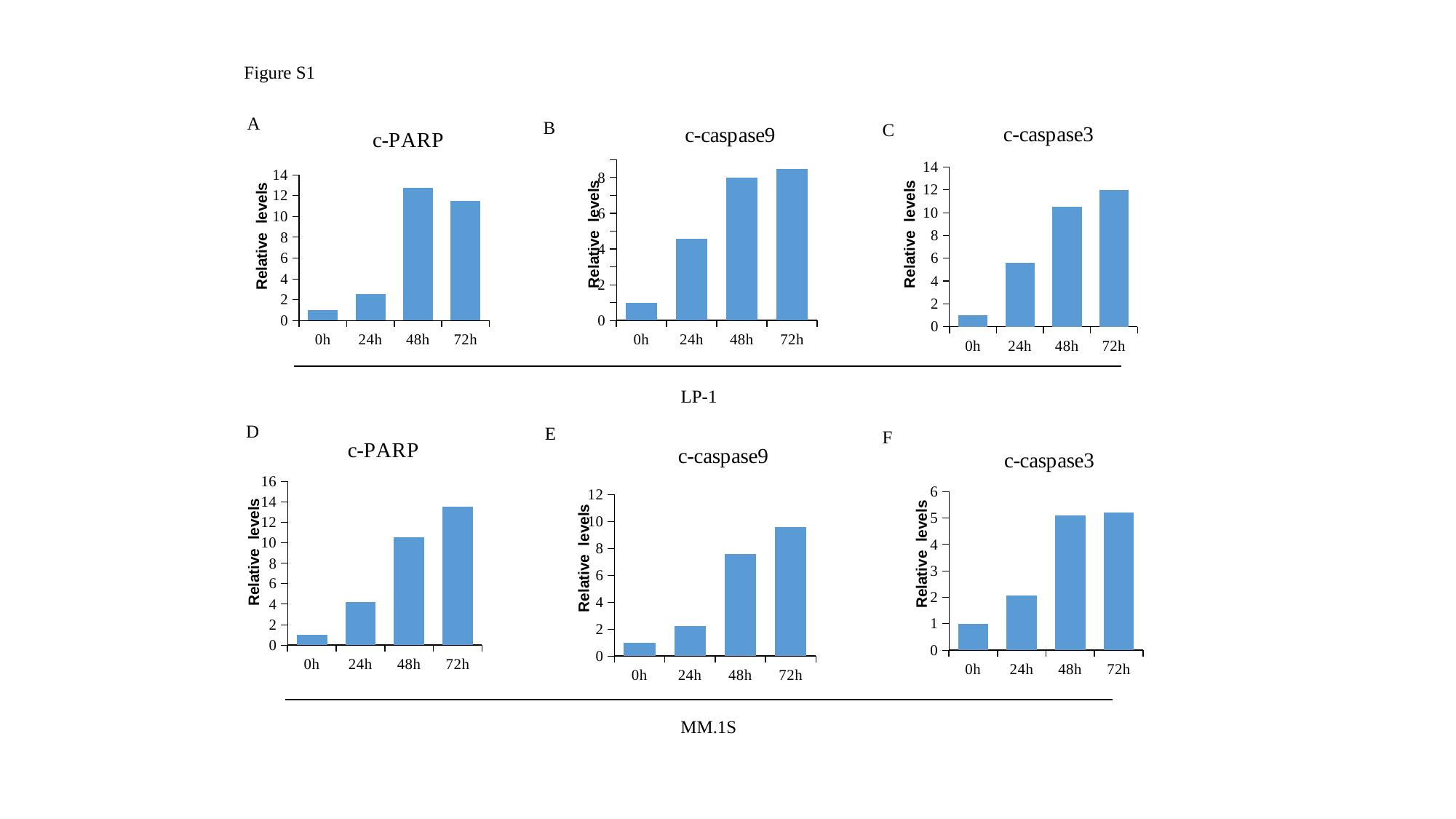
In chart D (c-PARP, MM.1S), which time point has the highest relative level? 72h In chart E (c-caspase9, MM.1S), is the value for 48h greater or less than 8? less In chart B (c-caspase9, LP-1), which time point has the lowest relative level? 0h In chart A (c-PARP, LP-1), is the value for 48h greater or less than 12? greater How many time points are shown on the x axis of chart F (c-caspase3, MM.1S)? 4 In chart C (c-caspase3, LP-1), do the relative levels rise or fall from 0h to 72h? rise What kind of chart is chart F (c-caspase3, MM.1S)? bar chart In chart E (c-caspase9, MM.1S), which is larger, the value for 48h or the value for 72h? 72h In chart A (c-PARP, LP-1), which time point has the highest relative level? 48h In chart C (c-caspase3, LP-1), is the value for 48h greater or less than 10? greater